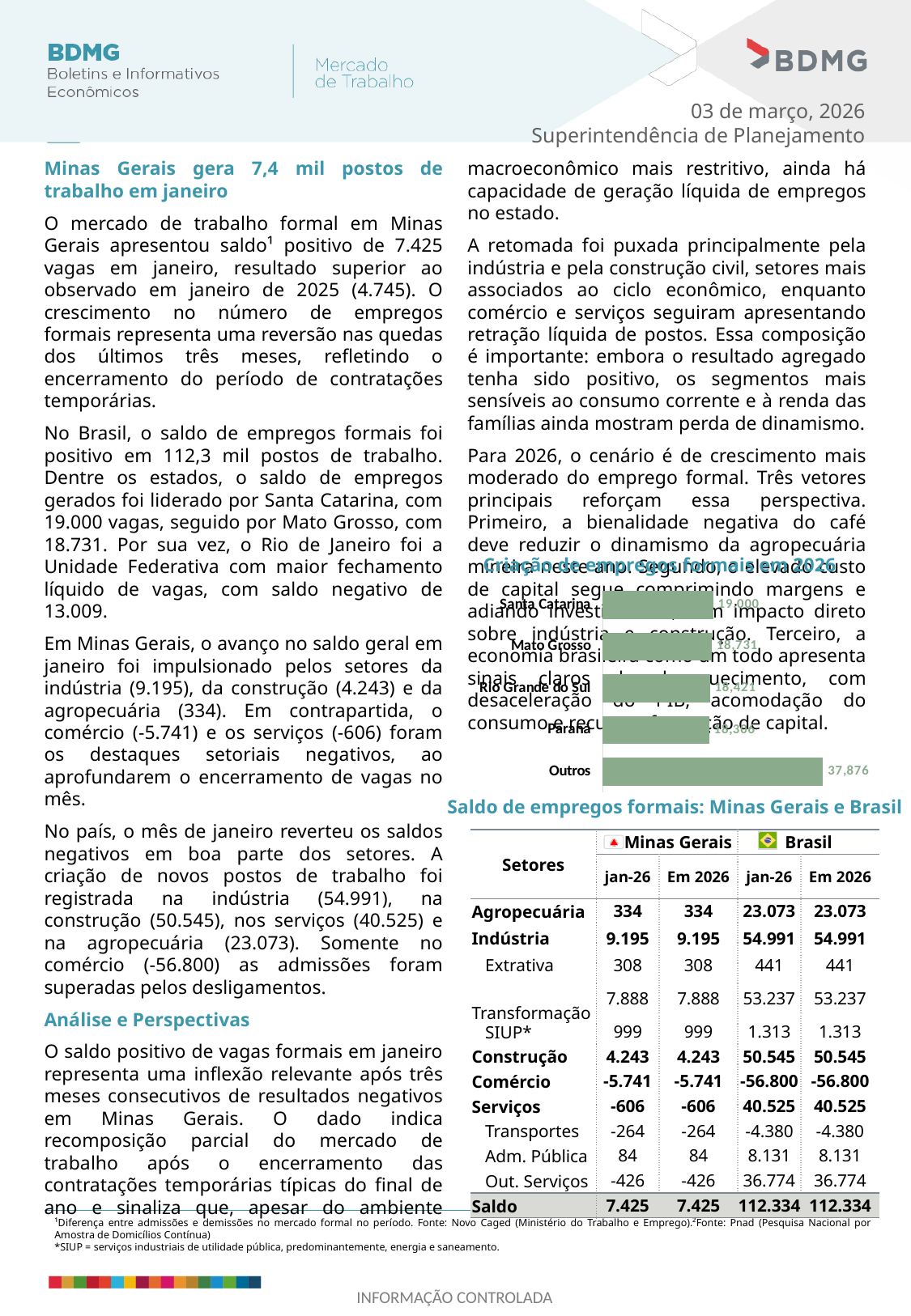
In the 'Criação de empregos formais em 2026' chart, what is the value for Rio Grande do Sul? 18,421 In the 'Criação de empregos formais em 2026' chart, what is the value for Outros? 37,876 In the 'Criação de empregos formais em 2026' chart, which is larger: Outros or Santa Catarina? Outros How many categories are shown in the 'Criação de empregos formais em 2026' chart? 5 Which category has the highest value in the 'Criação de empregos formais em 2026' chart? Outros What kind of chart is 'Criação de empregos formais em 2026'? bar chart In the 'Criação de empregos formais em 2026' chart, which is larger: Santa Catarina or Mato Grosso? Santa Catarina In the 'Criação de empregos formais em 2026' chart, what is the difference between Santa Catarina and Mato Grosso? 269 In the 'Criação de empregos formais em 2026' chart, what is the value for Santa Catarina? 19,000 What is the title of the bar chart on the slide? Criação de empregos formais em 2026 In the 'Criação de empregos formais em 2026' chart, what is the difference between Outros and Santa Catarina? 18,876 In the 'Criação de empregos formais em 2026' chart, what is the value for Mato Grosso? 18,731